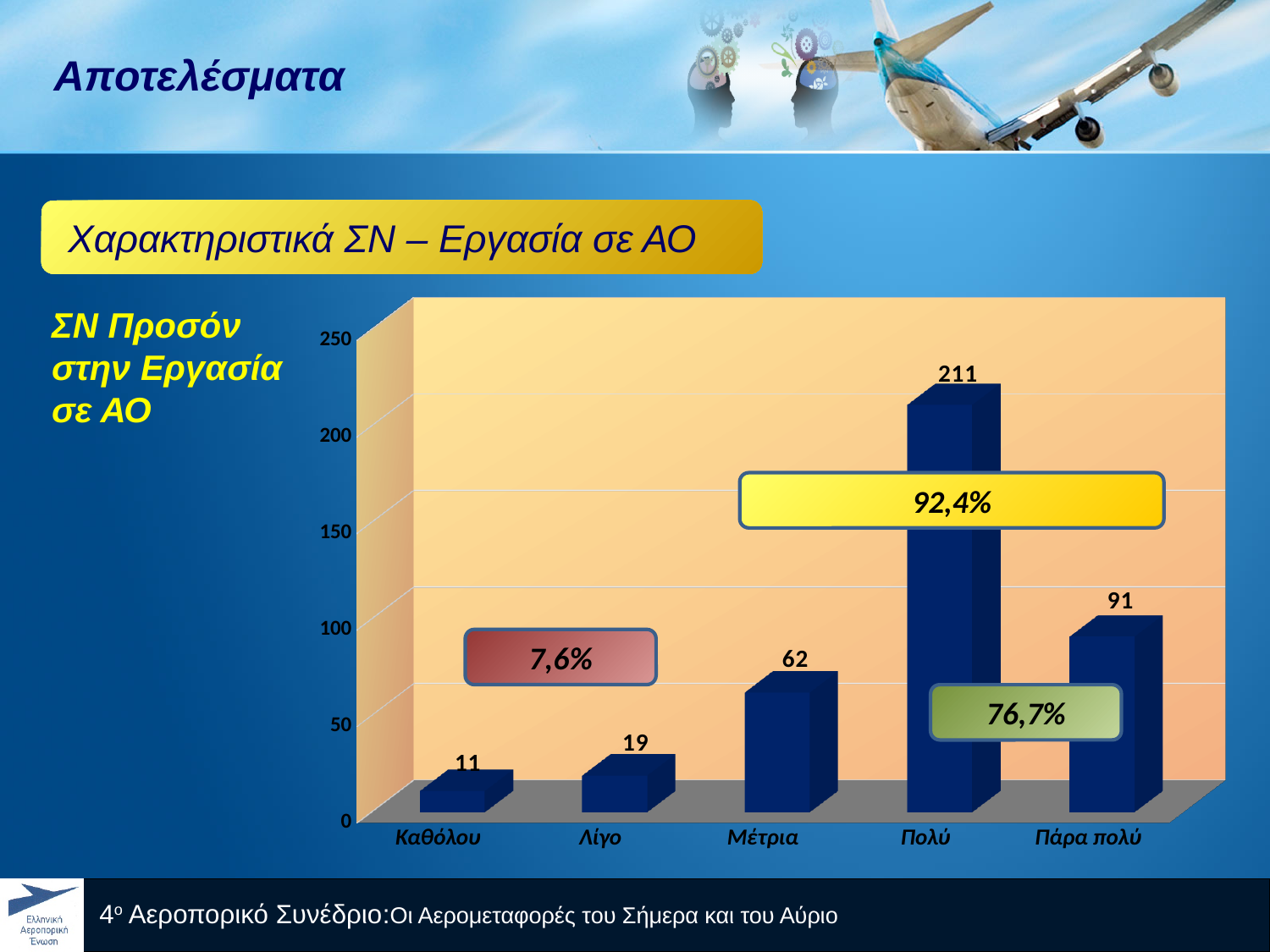
Is the value for Πολύ greater or less than 200? greater What is the value for Πολύ? 211 Which category has the lowest value? Καθόλου What is the difference between the values for Πολύ and Πάρα πολύ? 120 What kind of chart is shown on the slide? bar chart What is the value for Μέτρια? 62 How many categories are shown on the x axis? 5 Which is larger, the value for Λίγο or the value for Μέτρια? Μέτρια What is the value for Καθόλου? 11 What percentage is shown in the yellow callout box above the Πολύ bar? 92,4% What is the value for Πάρα πολύ? 91 Which category has the highest value? Πολύ